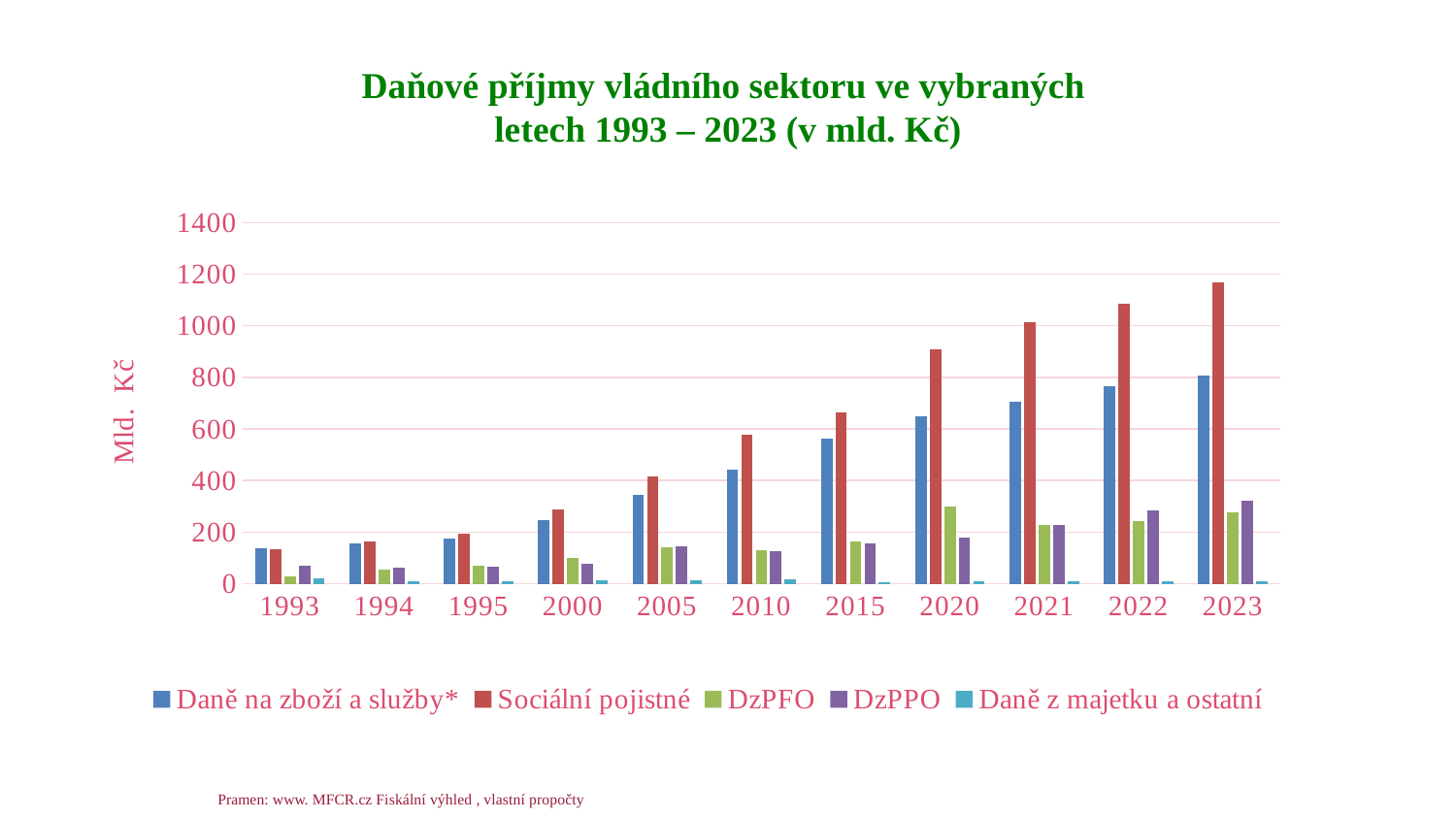
In which year is the value for Sociální pojistné the highest? 2023 How many series does the legend list? 5 Is the value for Sociální pojistné in 1993 greater or less than 200? less Which series has the lowest value in 2023? Daně z majetku a ostatní Does the value for Sociální pojistné rise or fall from 1993 to 2023? rise What is the label on the vertical axis? Mld. Kč Is the value for Sociální pojistné in 2023 greater or less than 1000? greater Which series has the highest value in 2023? Sociální pojistné Is the value for Daně na zboží a služby* in 2023 greater or less than 600? greater What kind of chart is shown on the slide? bar chart In 2020, which is larger: Sociální pojistné or Daně na zboží a služby*? Sociální pojistné How many years are shown on the x axis? 11